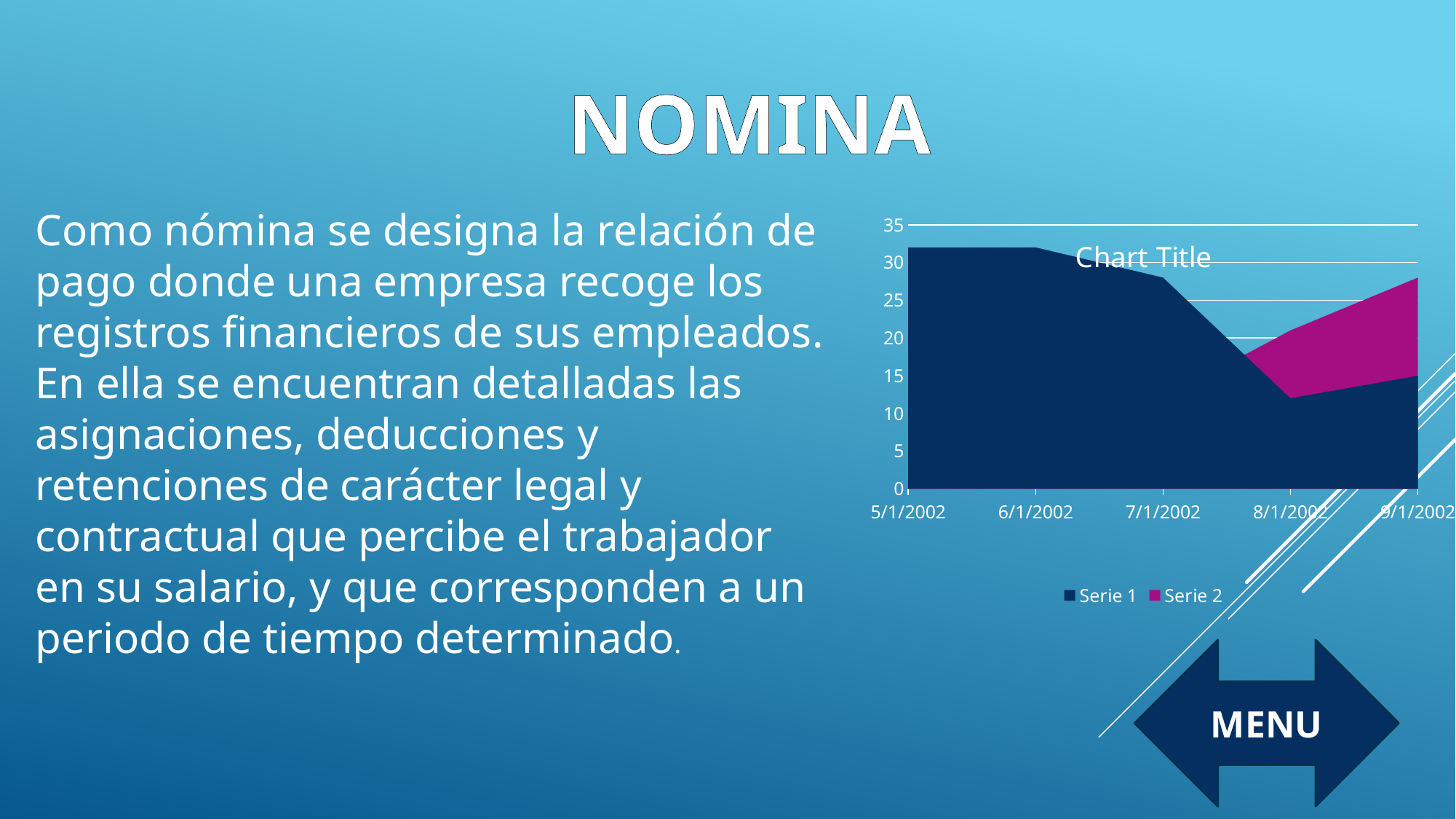
Is the value of Serie 1 at 7/1/2002 greater or less than 25? greater How many series does the chart legend list? 2 Does Serie 2 rise or fall from 8/1/2002 to 9/1/2002? rise Which is larger for Serie 1: the value at 6/1/2002 or the value at 8/1/2002? 6/1/2002 How many dates are shown on the x axis of the chart? 5 What is the title of the chart? Chart Title Is the value of Serie 1 at 5/1/2002 greater or less than 30? greater At which date does Serie 1 reach its lowest value? 8/1/2002 What are the names of the series in the chart legend? Serie 1 and Serie 2 What kind of chart is shown on the slide? area chart Does Serie 1 rise or fall from 5/1/2002 to 8/1/2002? fall Is the value of Serie 1 at 8/1/2002 greater or less than 15? less